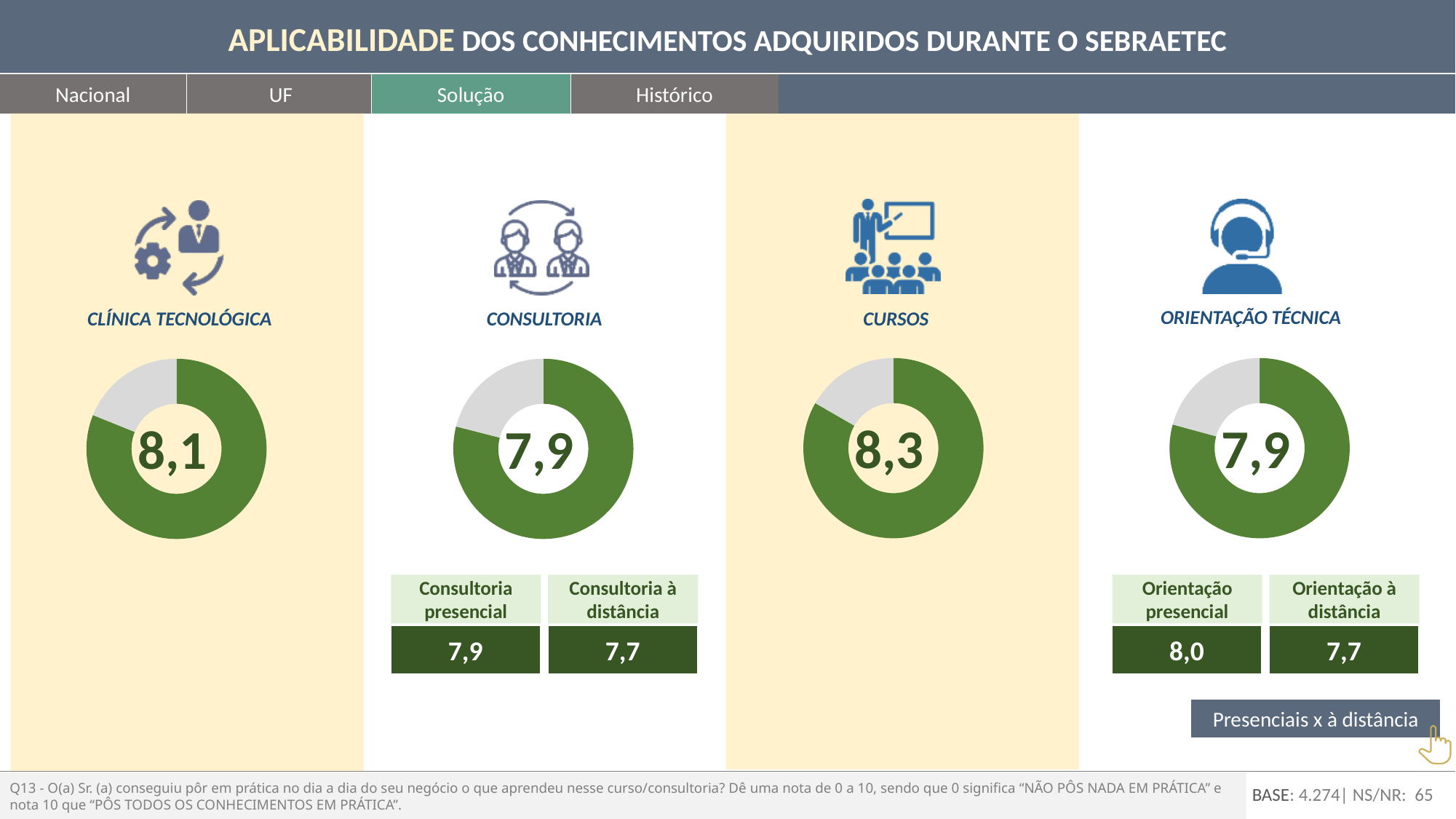
Which of the four solutions has the highest score shown in its donut chart? Cursos What value is shown in the centre of the Clínica Tecnológica donut chart? 8,1 How many donut charts are shown on the slide? 4 What value is shown in the centre of the Cursos donut chart? 8,3 What kind of chart is used to display each solution's score? Donut (pie) chart What value is shown in the centre of the Orientação Técnica donut chart? 7,9 Which has a higher score, Clínica Tecnológica or Consultoria? Clínica Tecnológica Under the Orientação Técnica chart, what is the score for Orientação presencial? 8,0 Under the Consultoria chart, what is the score for Consultoria à distância? 7,7 What is the difference between the Cursos score and the Clínica Tecnológica score? 0,2 What value is shown in the centre of the Consultoria donut chart? 7,9 What is the difference between the Orientação presencial and Orientação à distância scores? 0,3